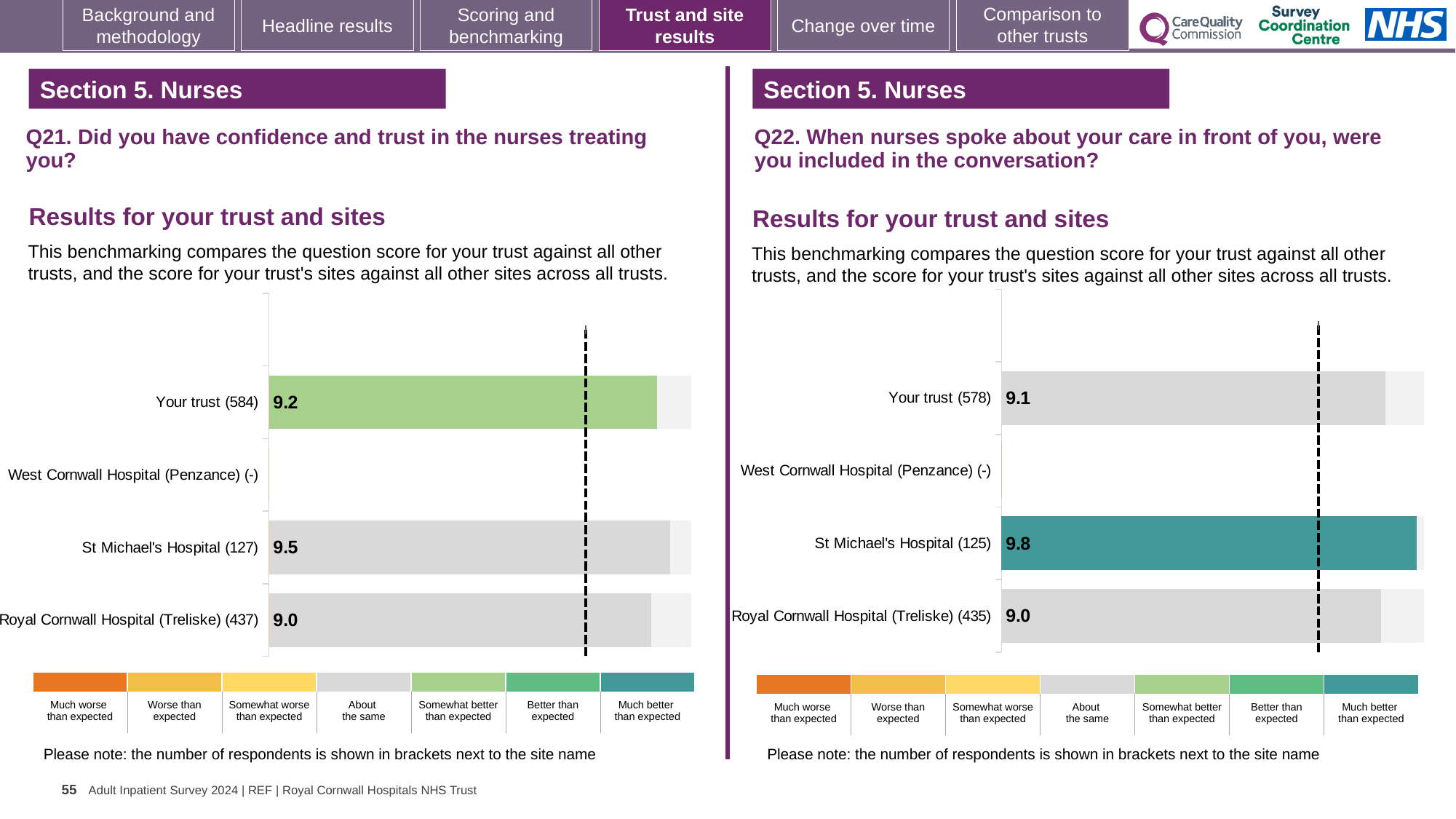
In the Q22 chart on the right, which is larger: the score for Your trust (578) or the score for St Michael's Hospital (125)? St Michael's Hospital (125) In the Q21 chart on the left, what is the score for Your trust (584)? 9.2 What kind of chart is used in the Q21 chart on the left? Bar chart In the Q21 chart on the left, what is the difference between the scores for St Michael's Hospital (127) and Royal Cornwall Hospital (Treliske) (437)? 0.5 In the Q21 chart on the left, which site or trust has the highest score? St Michael's Hospital (127) In the Q22 chart on the right, what is the score for Your trust (578)? 9.1 In the Q22 chart on the right, what is the score for Royal Cornwall Hospital (Treliske) (435)? 9.0 In the Q21 chart on the left, what is the score for St Michael's Hospital (127)? 9.5 In the Q22 chart on the right, what is the score for St Michael's Hospital (125)? 9.8 In the Q22 chart on the right, which benchmark category does the colour of the St Michael's Hospital (125) bar correspond to? Much better than expected In the Q22 chart on the right, which site or trust has the lowest score among those with a value shown? Royal Cornwall Hospital (Treliske) (435) In the Q21 chart on the left, what is the score for Royal Cornwall Hospital (Treliske) (437)? 9.0